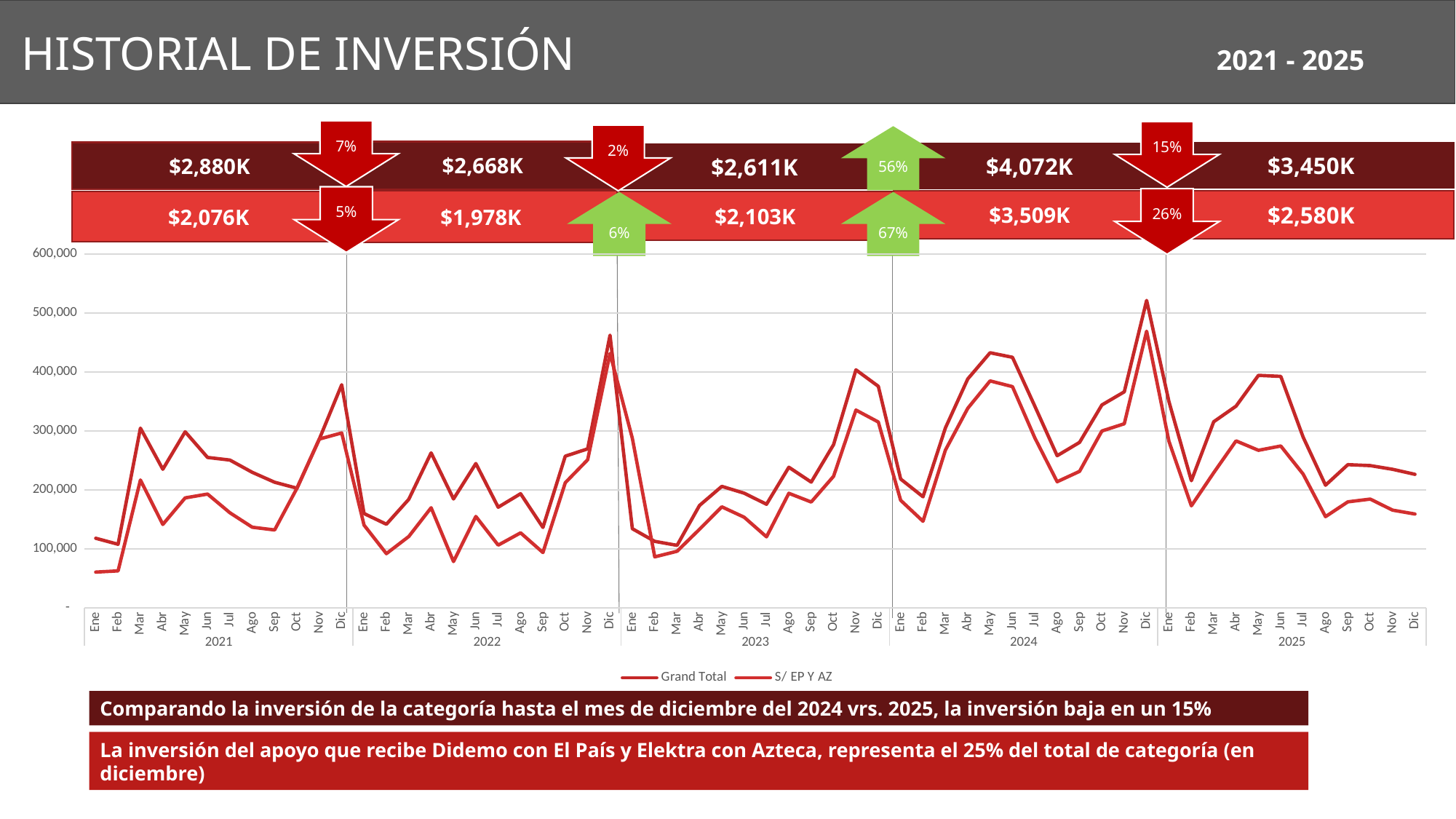
In the dark red row of annual totals above the chart, which year has the highest value? 2024 In the dark red row of annual totals above the chart, what value is shown for 2021? $2,880K How many years are shown along the x axis of the chart? 5 What kind of chart is shown on the slide? line chart Is the Grand Total value for Dec 2024 greater or less than 500,000? greater In the dark red row of annual totals, what is the difference between the 2024 value and the 2025 value? $622K In Dec 2024, which series has the larger value, Grand Total or S/ EP Y AZ? Grand Total What are the two series named in the chart legend? Grand Total and S/ EP Y AZ In the lighter red row of annual totals above the chart, what value is shown for 2024? $3,509K In the dark red row of annual totals above the chart, which year has the lowest value? 2023 How many series does the chart legend list? 2